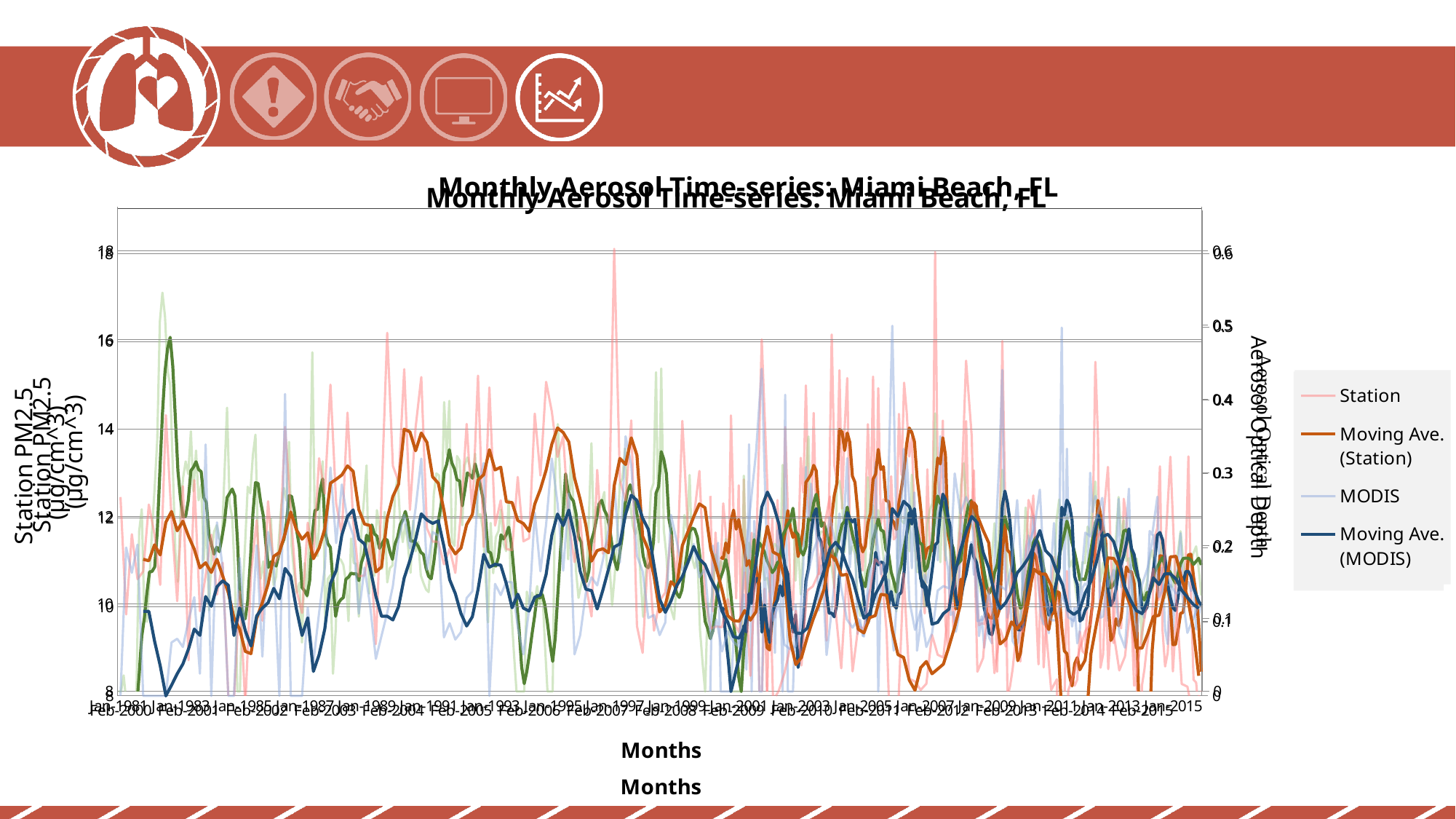
Which series is drawn in dark blue according to the legend? Moving Ave. (MODIS) What is the highest tick value shown on the right-hand axis (Aerosol Optical Depth)? 0.6 What kind of chart is shown on the slide? Line chart What is the title of the chart? Monthly Aerosol Time-series: Miami Beach, FL Is the peak of the Moving Ave. (Station) line greater or less than 16 on the left axis? less How many series does the legend list? 4 Is the peak of the Moving Ave. (MODIS) line greater or less than 0.4 on the right axis? less What is the label of the x axis? Months What is the lowest tick value shown on the left-hand axis (Station PM2.5)? 8